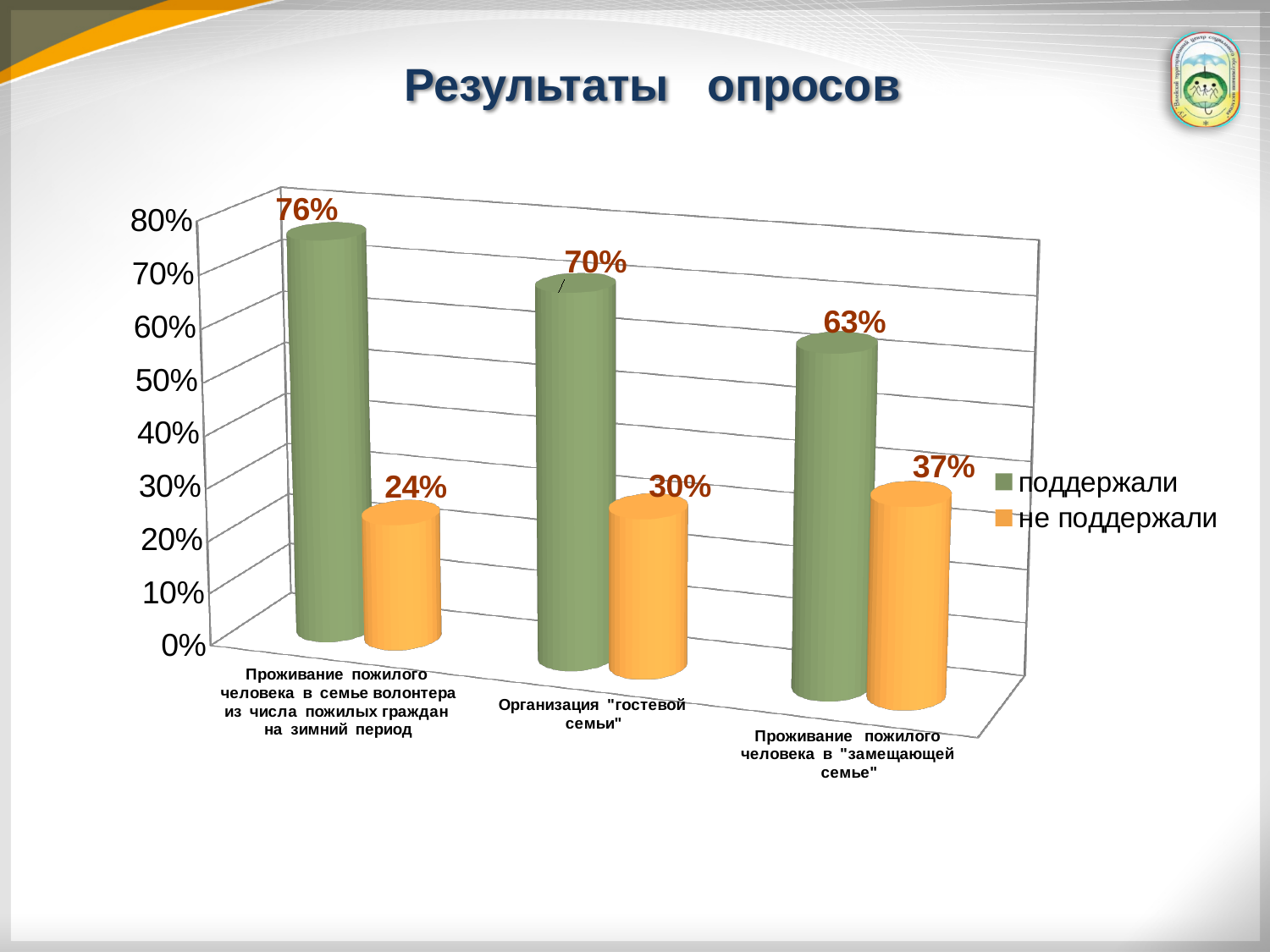
What kind of chart is shown on the slide? Bar chart How many series does the legend list? 2 What percentage of respondents supported (поддержали) the option 'Проживание пожилого человека в семье волонтера из числа пожилых граждан на зимний период'? 76% What percentage of respondents did not support (не поддержали) the option 'Проживание пожилого человека в "замещающей семье"'? 37% Which option received the highest share of 'поддержали' responses? Проживание пожилого человека в семье волонтера из числа пожилых граждан на зимний период What is the difference between the 'поддержали' and 'не поддержали' values for 'Организация "гостевой семьи"'? 40% How many categories are shown on the x axis of the chart? 3 What is the title of the slide? Результаты опросов What percentage of respondents supported (поддержали) the option 'Организация "гостевой семьи"'? 70% Which is larger: the 'не поддержали' value for 'Организация "гостевой семьи"' or for 'Проживание пожилого человека в "замещающей семье"'? Проживание пожилого человека в "замещающей семье" Do the 'поддержали' values rise or fall from left to right across the categories? Fall Which option received the lowest share of 'не поддержали' responses? Проживание пожилого человека в семье волонтера из числа пожилых граждан на зимний период